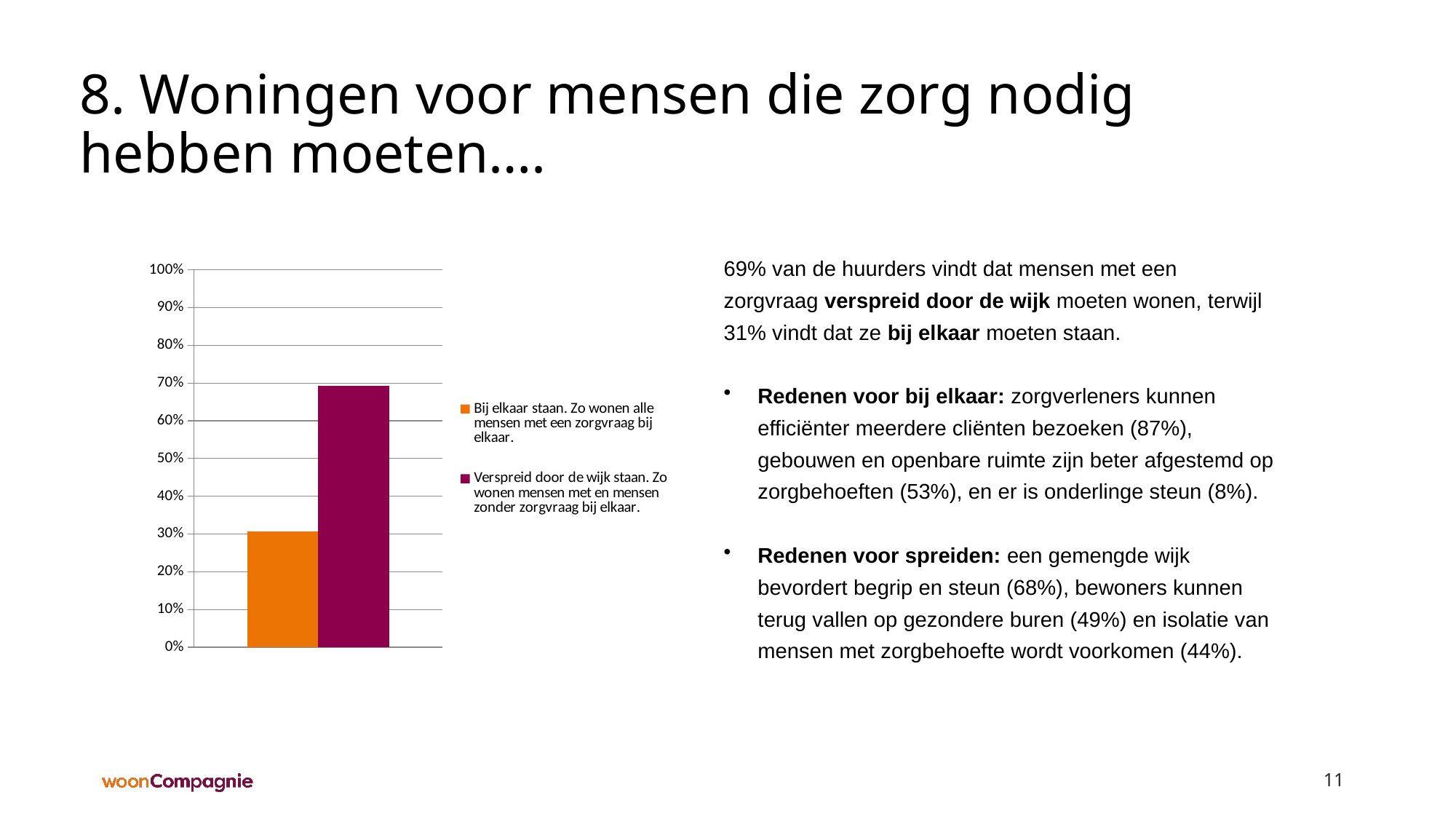
Is the value for 'Verspreid door de wijk staan' greater or less than 60%? greater Is the value for 'Verspreid door de wijk staan' greater or less than 80%? less Is the value for 'Bij elkaar staan' greater or less than 20%? greater How many series does the chart legend list? 2 Which series has the highest bar in the chart? Verspreid door de wijk staan Which is larger in the chart: the bar for 'Bij elkaar staan' or the bar for 'Verspreid door de wijk staan'? Verspreid door de wijk staan What kind of chart is shown on the slide? bar chart Which series has the lowest bar in the chart? Bij elkaar staan What is the maximum value shown on the chart's vertical axis? 100% How many bars are plotted in the chart? 2 What colour is the bar for 'Bij elkaar staan' in the chart? orange